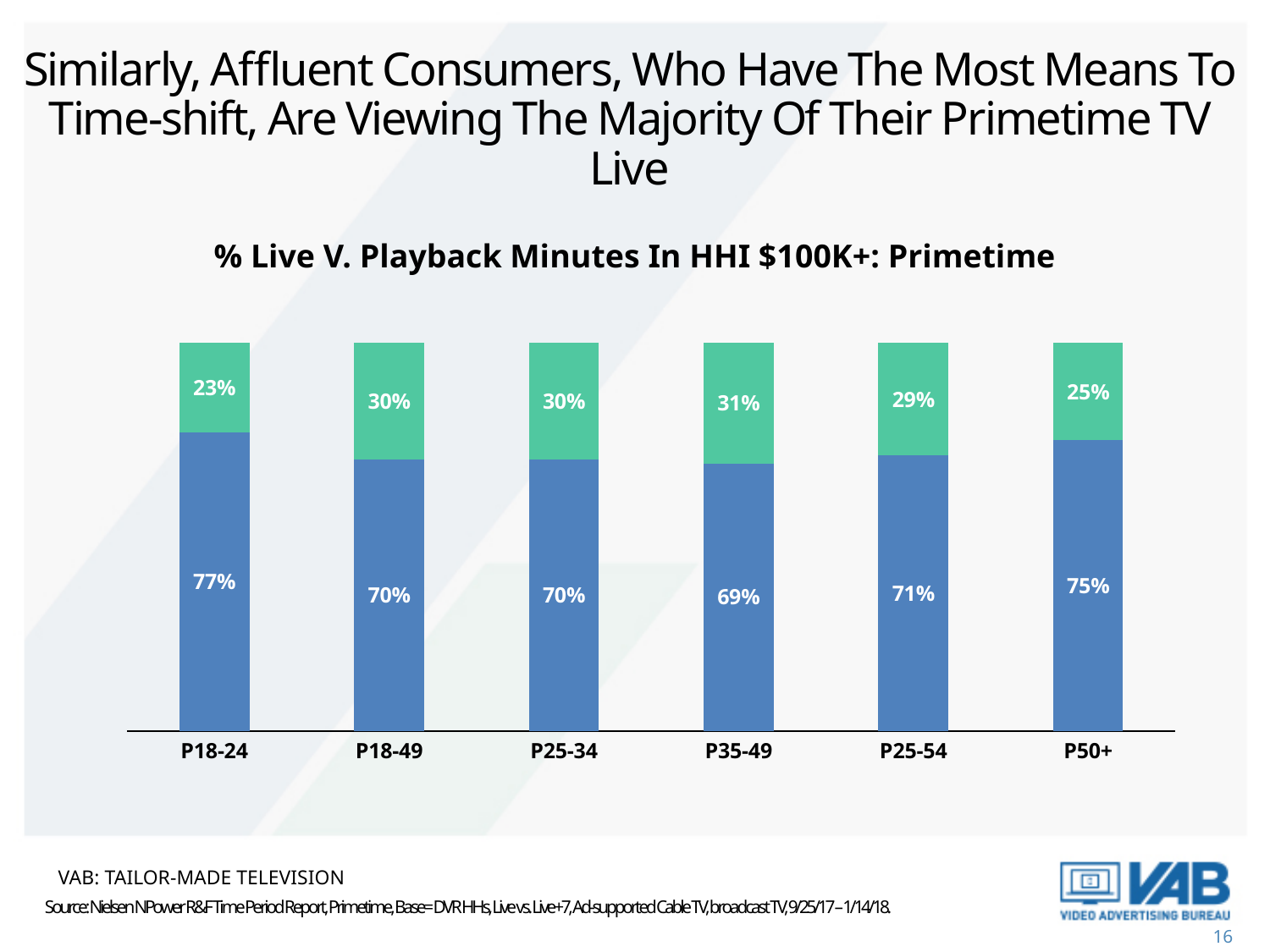
How many categories are shown on the x axis? 6 What kind of chart is shown on the slide? Stacked bar chart Which is larger: the blue segment for P25-54 or the blue segment for P50+? P50+ Which category has the highest blue (bottom) segment value? P18-24 Which category has the highest green (top) segment value? P35-49 What is the title of the chart? % Live V. Playback Minutes In HHI $100K+: Primetime What is the value of the blue (bottom) segment for P50+? 75% What is the difference between the blue segment values for P18-24 and P35-49? 8% What is the value of the green (top) segment for P25-54? 29% What is the value of the blue (bottom) segment for P18-24? 77% What is the value of the green (top) segment for P35-49? 31% Which category has the lowest blue (bottom) segment value? P35-49